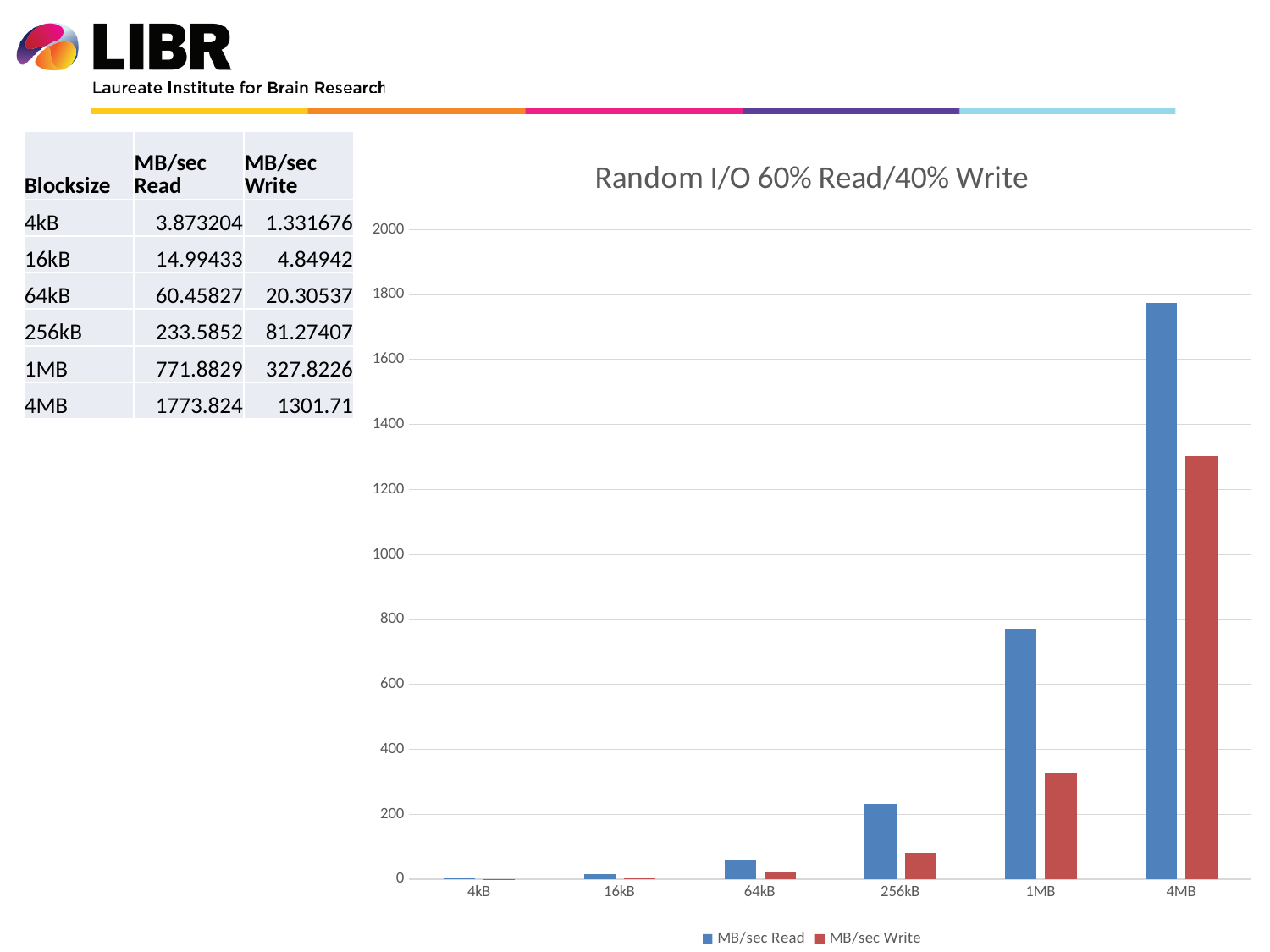
Is the MB/sec Read value for 1MB greater or less than 600? greater According to the table, what is the MB/sec Read value for the 4MB blocksize? 1773.824 According to the table, what is the MB/sec Write value for the 1MB blocksize? 327.8226 Which blocksize has the highest MB/sec Read value? 4MB Which is larger for the 4MB blocksize, MB/sec Read or MB/sec Write? MB/sec Read Which blocksize has the lowest MB/sec Write value? 4kB How many blocksize categories are shown on the x axis of the chart? 6 What type of chart is shown on the slide? bar chart How many series does the chart legend list? 2 Is the MB/sec Write value for 256kB greater or less than 200? less Do the MB/sec Read values rise or fall as blocksize increases along the x axis? rise What is the title of the chart? Random I/O 60% Read/40% Write